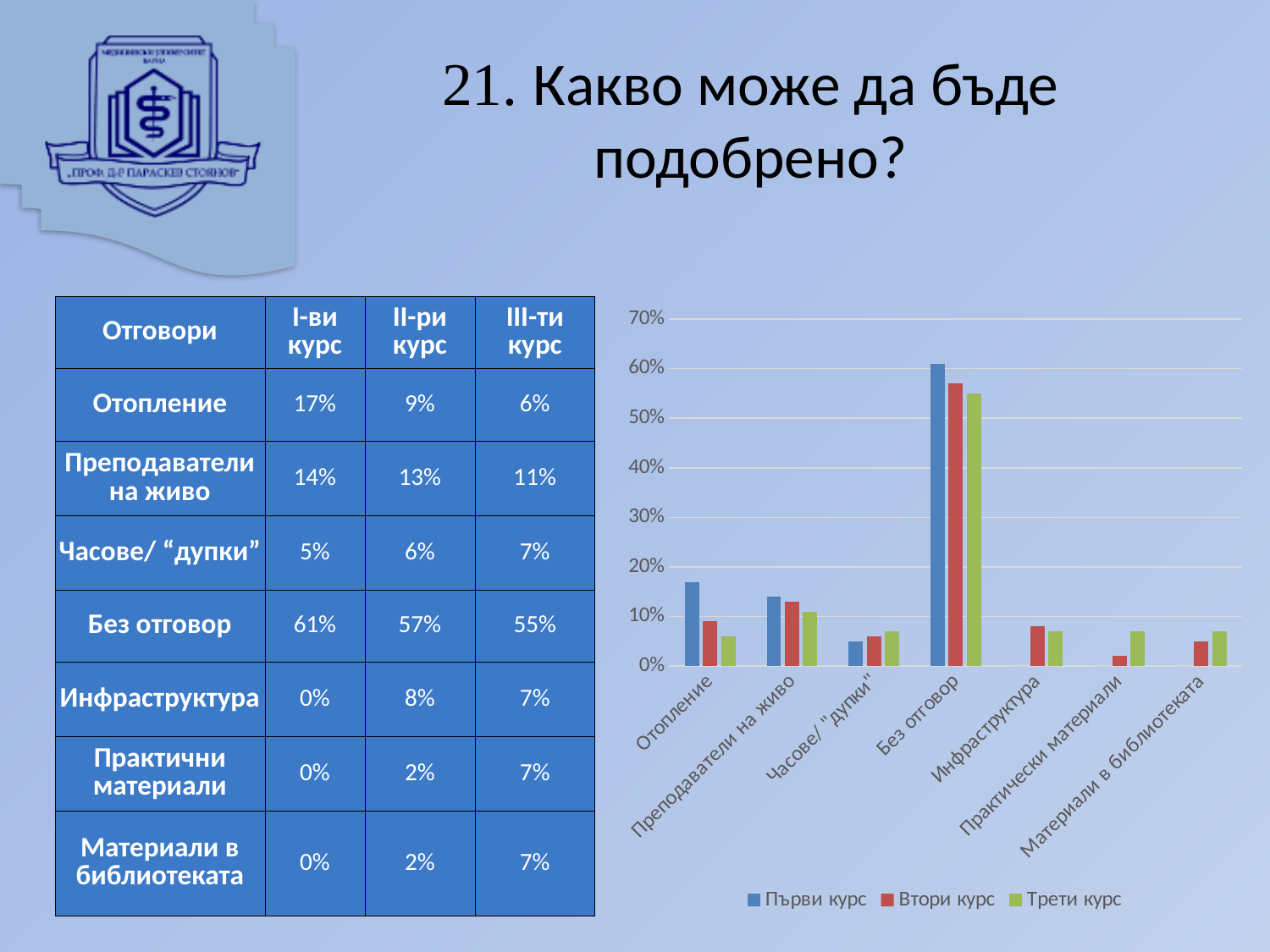
Which is larger for Отопление: the Първи курс value or the Трети курс value? Първи курс What kind of chart is shown on the slide? bar chart What is the value for Отопление in the Първи курс series? 17% What is the value for Без отговор in the Втори курс series? 57% Is the value for Часове/ "дупки" in the Трети курс series greater or less than 10%? less What is the value for Инфраструктура in the Трети курс series? 7% What is the difference between the Първи курс and Трети курс values for Без отговор? 6% Which category has the highest value for Първи курс? Без отговор Is the value for Без отговор in the Първи курс series greater or less than 50%? greater Which series is shown in red in the chart? Втори курс How many categories are shown on the x axis of the chart? 7 How many series does the chart legend list? 3